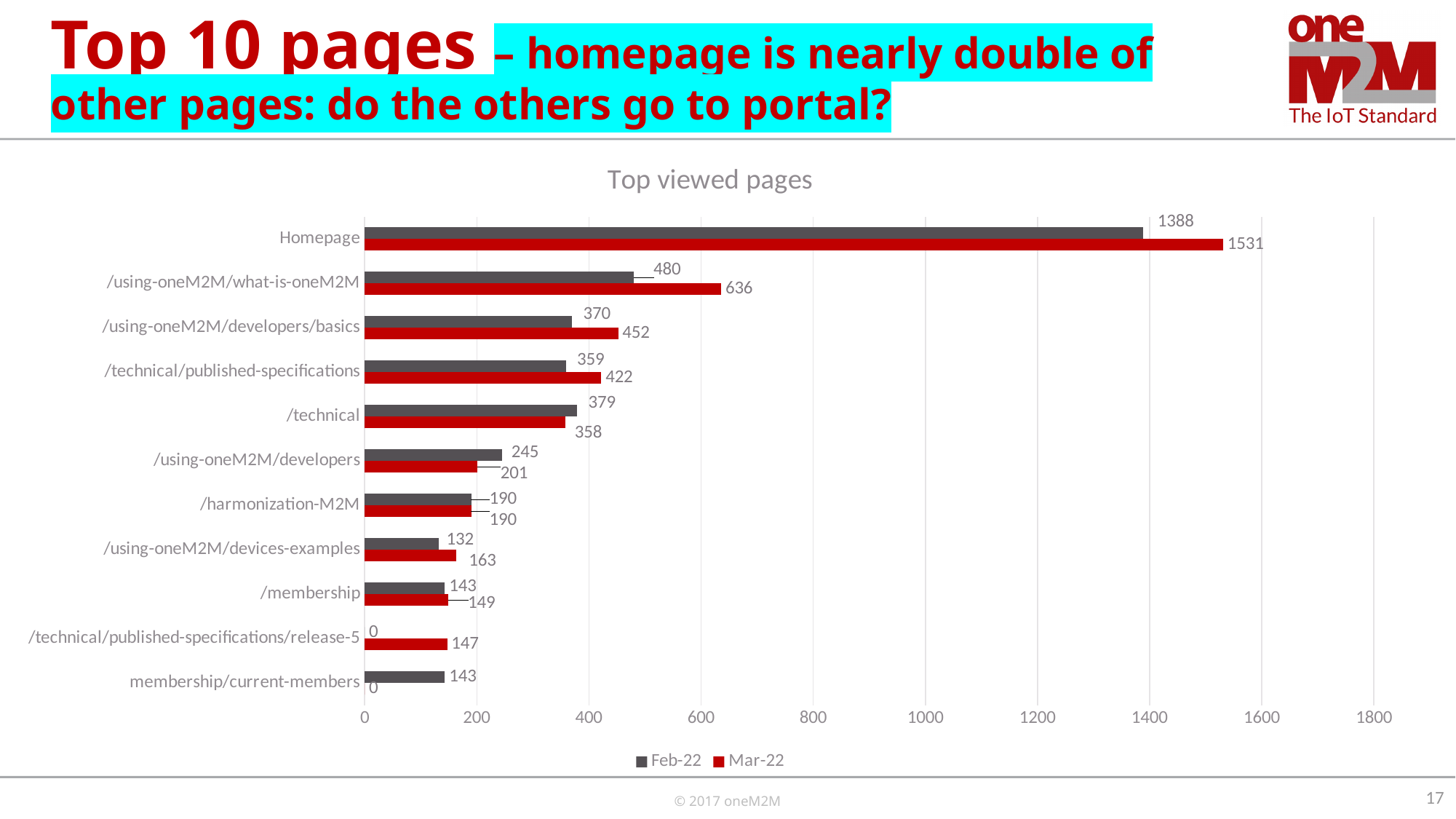
How many pages are listed in the chart? 11 What is the Feb-22 value for /using-oneM2M/what-is-oneM2M? 480 Is the Mar-22 value for /using-oneM2M/what-is-oneM2M greater or less than 600? greater What is the difference between the Mar-22 and Feb-22 values for Homepage? 143 Which is larger for /technical: the Feb-22 value or the Mar-22 value? Feb-22 How many series does the legend list? 2 Which page has the lowest Feb-22 value? /technical/published-specifications/release-5 What is the Mar-22 value for Homepage? 1531 What kind of chart is shown? bar chart What is the Mar-22 value for /technical/published-specifications? 422 What is the title of the chart? Top viewed pages Which page has the highest Mar-22 value? Homepage